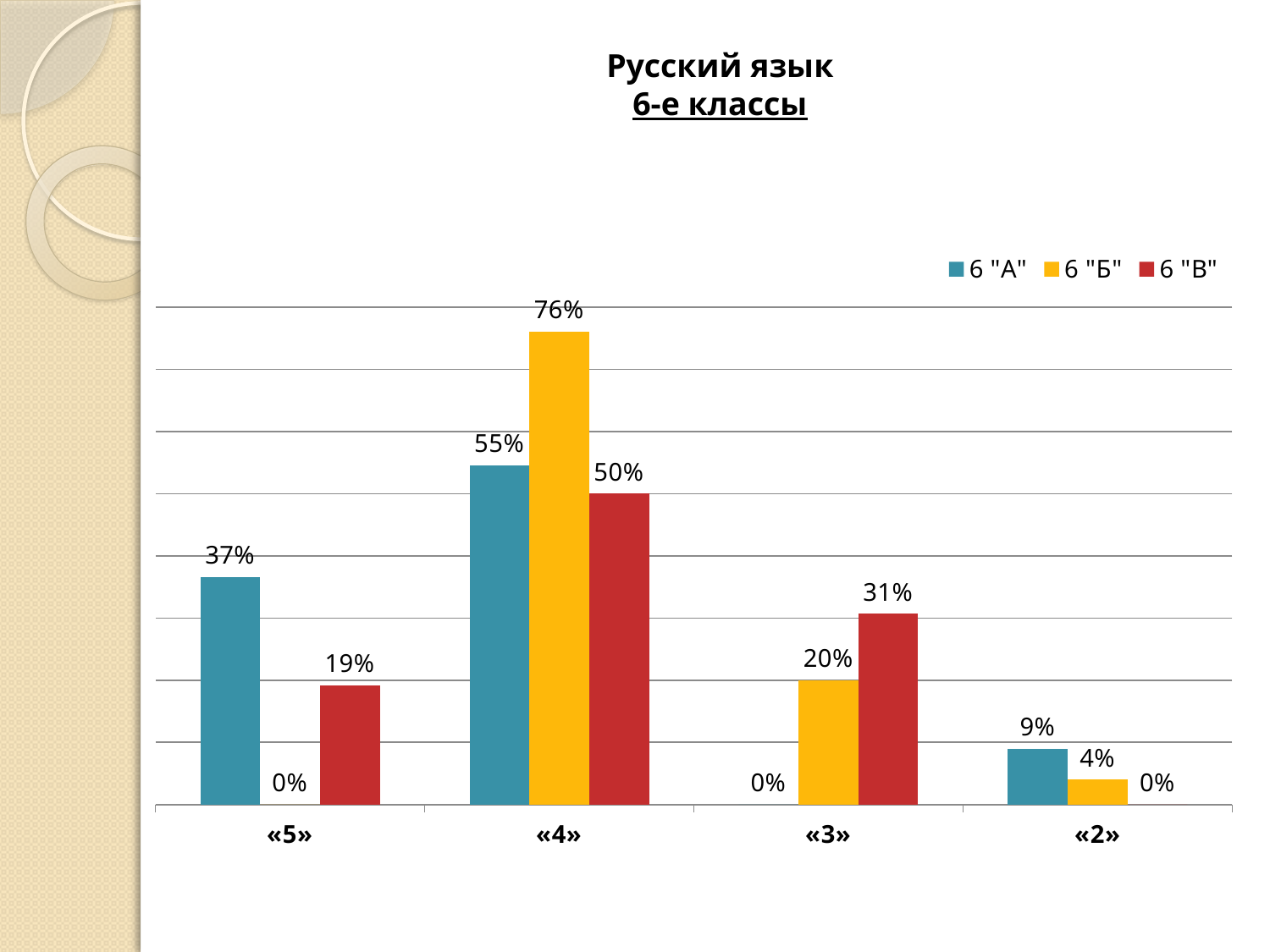
What is the difference between the 6 "Б" and 6 "В" values in the «4» category? 26% What is the value for 6 "В" in the «3» category? 31% What is the title of the chart? Русский язык 6-е классы What is the value for 6 "Б" in the «4» category? 76% What kind of chart is shown on the slide? Bar chart Which class has the highest value in the «4» category? 6 "Б" What is the value for 6 "Б" in the «2» category? 4% Which is larger in the «3» category: 6 "Б" or 6 "В"? 6 "В" How many series does the legend list? 3 Which class has the lowest value in the «5» category? 6 "Б" How many categories are shown on the x axis? 4 What is the value for 6 "А" in the «5» category? 37%